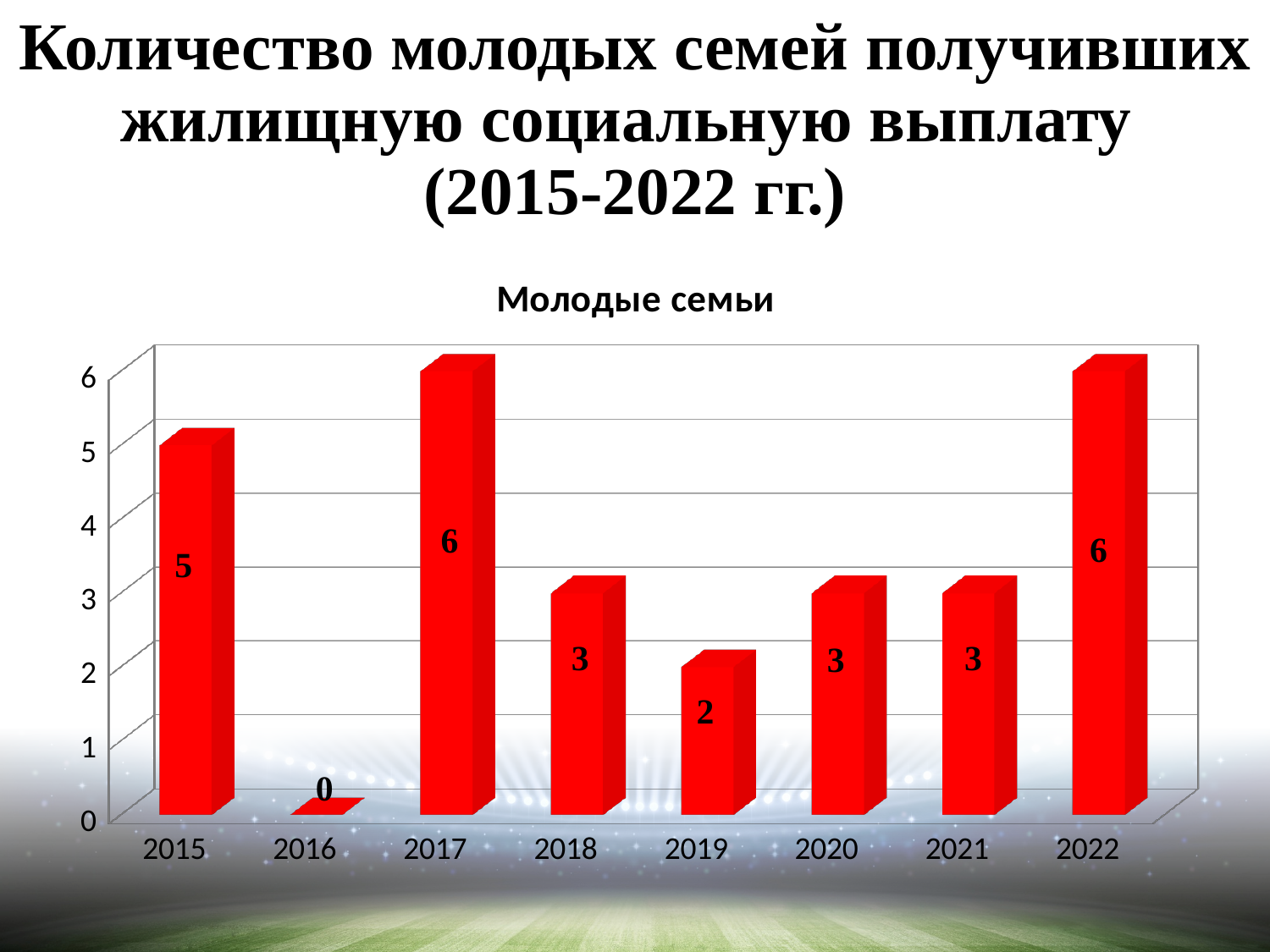
What is the value for 2016? 0 What is the value for 2021? 3 What is the highest value shown in the chart? 6 What is the title of the chart? Молодые семьи What is the difference between the values for 2015 and 2019? 3 What kind of chart is shown on the slide? Bar chart Which year has the lowest value? 2016 What is the difference between the values for 2017 and 2018? 3 What is the value for 2019? 2 What is the value for 2015? 5 Which is larger, the value for 2015 or the value for 2020? 2015 How many years are shown on the x axis? 8